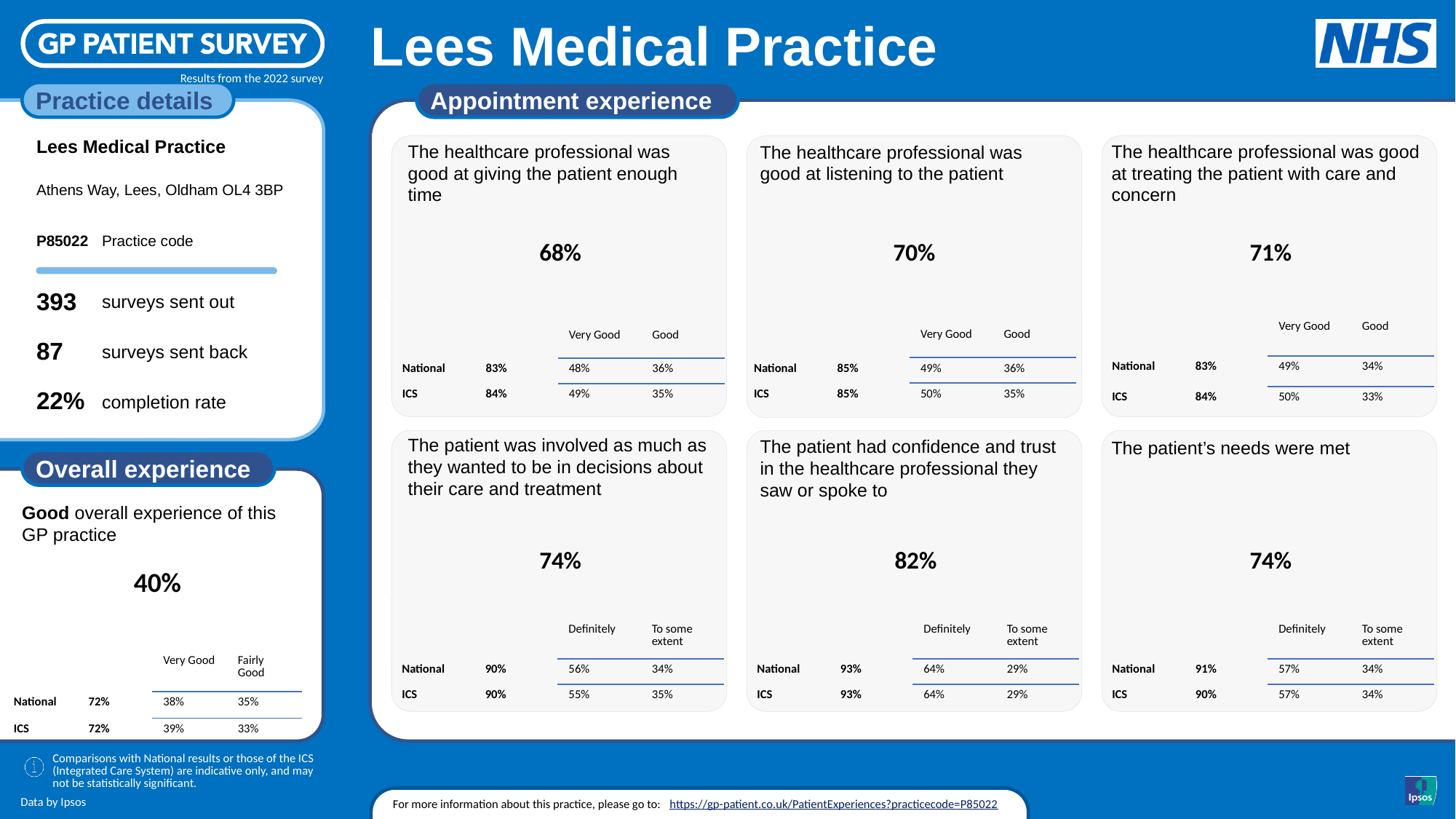
In the 'Appointment experience' section, which of the six questions has the highest practice percentage? The patient had confidence and trust in the healthcare professional they saw or spoke to In the 'Appointment experience' section, is the practice percentage for 'The patient was involved as much as they wanted to be in decisions about their care and treatment' (74%) higher or lower than the National figure (90%)? lower In the 'Appointment experience' section, what is the practice percentage for 'The healthcare professional was good at listening to the patient'? 70% In the 'Appointment experience' section, what is the practice percentage for 'The healthcare professional was good at giving the patient enough time'? 68% In the 'Appointment experience' section, for 'The healthcare professional was good at treating the patient with care and concern', what is the ICS 'Good' percentage? 33% In the 'Appointment experience' section, which of the six questions has the lowest practice percentage? The healthcare professional was good at giving the patient enough time In the 'Overall experience' section, what percentage of patients reported a good overall experience of this GP practice? 40% In the 'Overall experience' section, what is the difference between the National figure (72%) and the practice figure (40%)? 32 percentage points In the 'Appointment experience' section, what is the practice percentage for 'The patient had confidence and trust in the healthcare professional they saw or spoke to'? 82% In the 'Overall experience' section, what is the ICS 'Very Good' percentage? 39% In the 'Appointment experience' section, what is the National figure for 'The patient's needs were met'? 91% In the 'Overall experience' section, what is the National figure for good overall experience? 72%